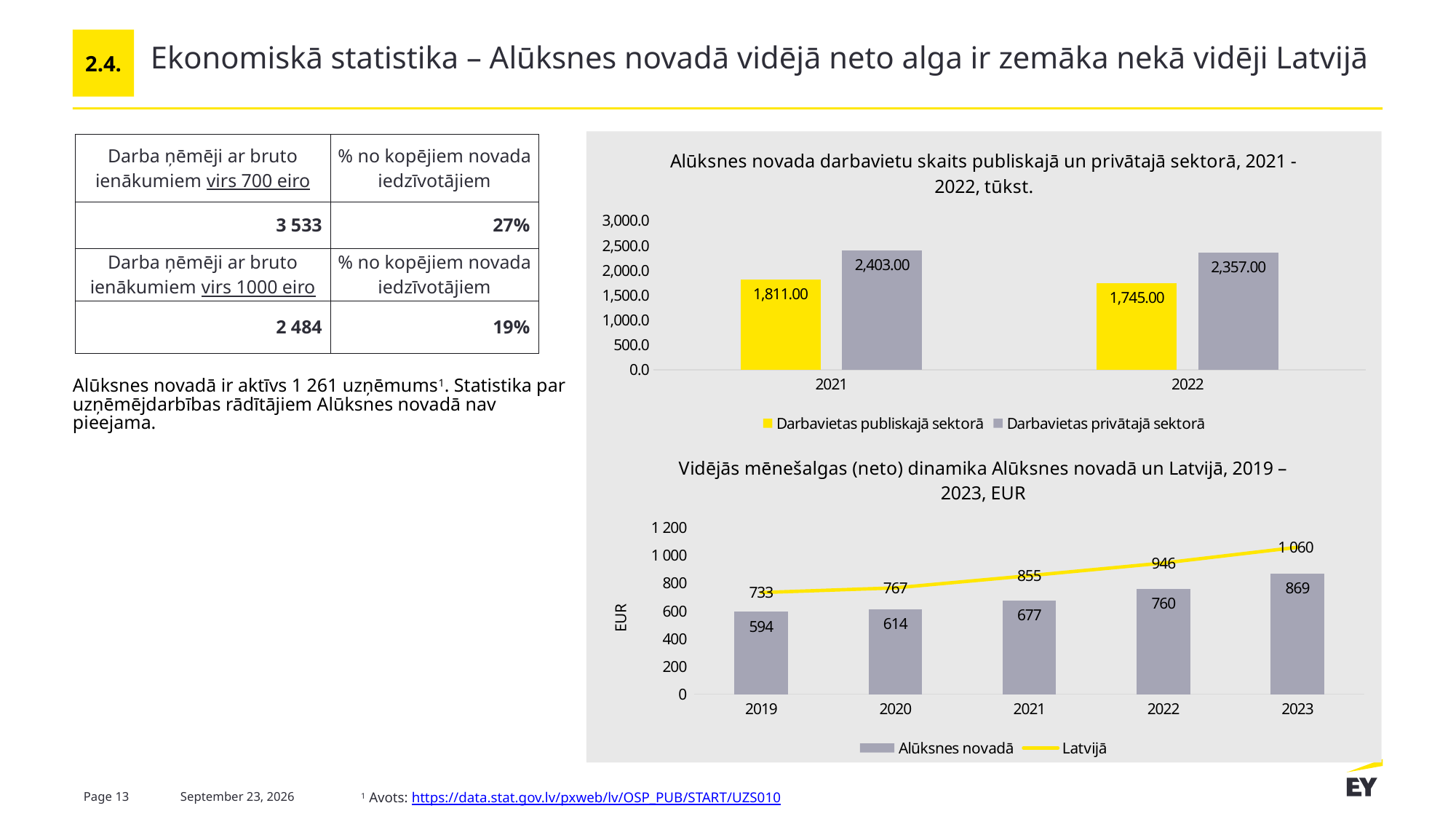
In the bottom chart (Vidējās mēnešalgas (neto) dinamika), which year has the lowest value for Alūksnes novadā? 2019 In the bottom chart (Vidējās mēnešalgas (neto) dinamika), what is the value for Latvijā in 2023? 1 060 In the top chart (Alūksnes novada darbavietu skaits publiskajā un privātajā sektorā), what is the value for Darbavietas privātajā sektorā in 2022? 2,357.00 In the bottom chart (Vidējās mēnešalgas (neto) dinamika), what is the difference between Latvijā and Alūksnes novadā in 2022? 186 What kind of chart is the top chart (Alūksnes novada darbavietu skaits publiskajā un privātajā sektorā)? bar chart In the top chart (Alūksnes novada darbavietu skaits publiskajā un privātajā sektorā), does the value for Darbavietas publiskajā sektorā rise or fall from 2021 to 2022? fall In the top chart (Alūksnes novada darbavietu skaits publiskajā un privātajā sektorā), how many series does the legend list? 2 In the bottom chart (Vidējās mēnešalgas (neto) dinamika), how many years are shown on the x axis? 5 In the bottom chart (Vidējās mēnešalgas (neto) dinamika), what is the value for Alūksnes novadā in 2021? 677 In the top chart (Alūksnes novada darbavietu skaits publiskajā un privātajā sektorā), what is the difference between Darbavietas privātajā sektorā and Darbavietas publiskajā sektorā in 2021? 592.00 In the bottom chart (Vidējās mēnešalgas (neto) dinamika), which is larger in 2020: Alūksnes novadā or Latvijā? Latvijā In the top chart (Alūksnes novada darbavietu skaits publiskajā un privātajā sektorā), what is the value for Darbavietas publiskajā sektorā in 2021? 1,811.00